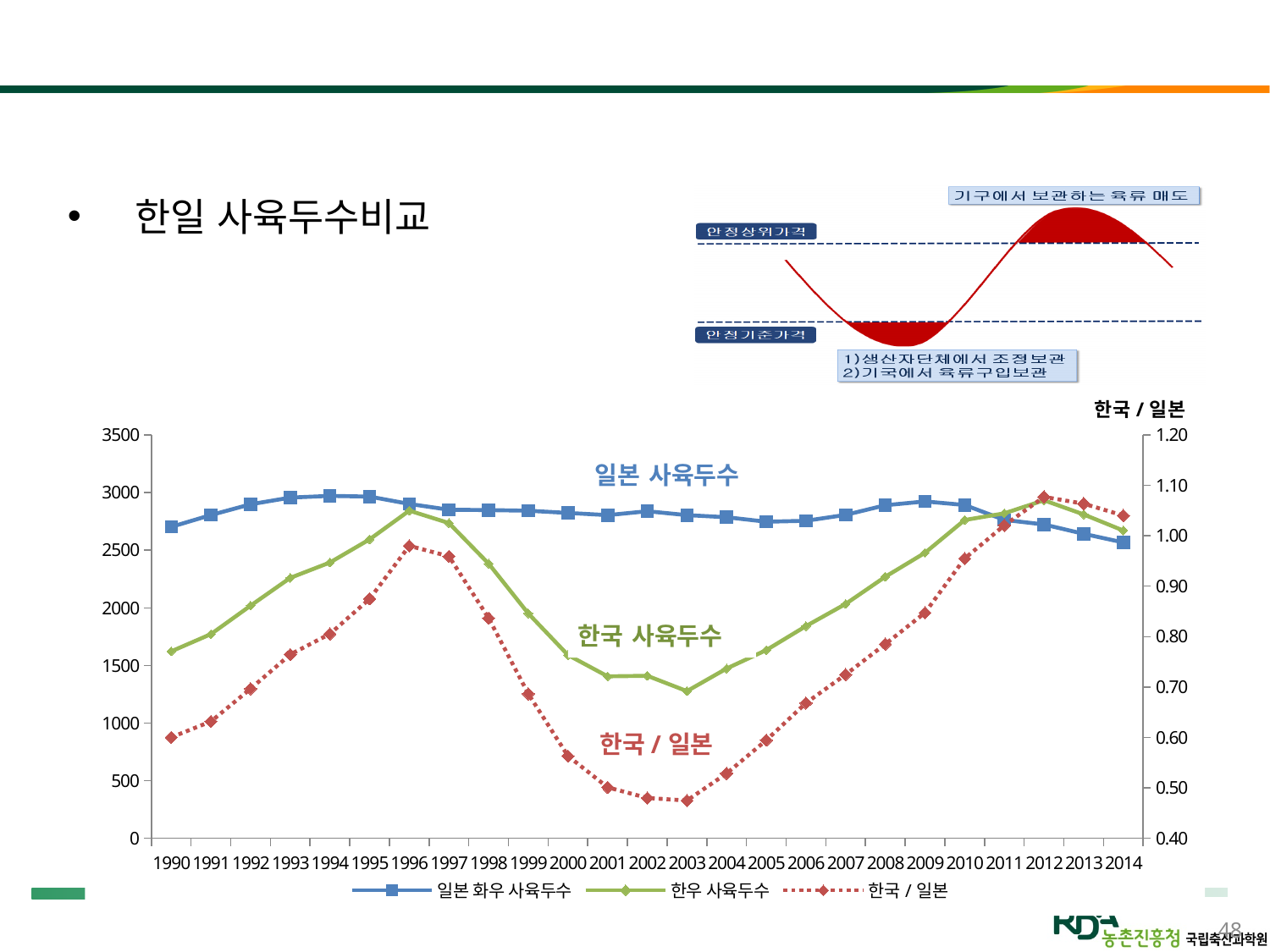
In which year is 한우 사육두수 at its lowest? 2003 How many series does the chart legend list? 3 In 2003, which is larger: 일본 화우 사육두수 or 한우 사육두수? 일본 화우 사육두수 What label is shown above the right-hand axis of the chart? 한국 / 일본 Is the value for 한국 / 일본 in 2012 greater or less than 1.00? greater Is the value for 한국 / 일본 in 2003 greater or less than 0.50? less Is the value for 일본 화우 사육두수 in 1990 greater or less than 2500? greater How many years are plotted along the x axis of the chart? 25 What kind of chart is shown on the slide? line chart In 2012, which is larger: 일본 화우 사육두수 or 한우 사육두수? 한우 사육두수 Does 한우 사육두수 rise or fall from 2003 to 2012? rise